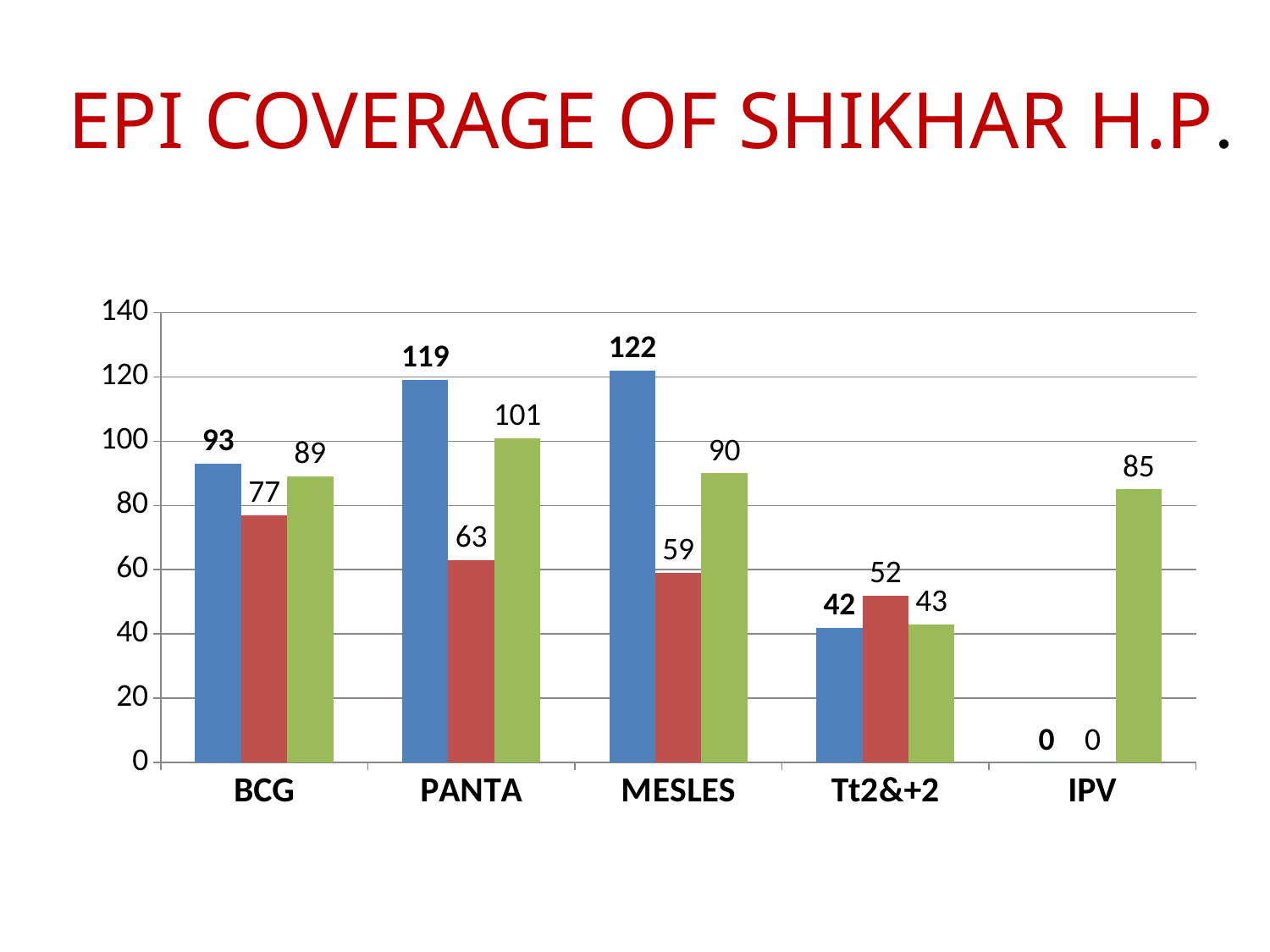
What is the value of the red bar for Tt2&+2? 52 Is the value of the blue bar for BCG greater or less than 100? less What is the difference between the blue bar and the red bar for PANTA? 56 What is the value of the blue bar for MESLES? 122 What is the value of the green bar for IPV? 85 Which is larger for BCG, the red bar or the green bar? the green bar Which category has the lowest green bar? Tt2&+2 Which category has the highest blue bar? MESLES How many categories are shown on the x axis? 5 What is the title of the slide? EPI COVERAGE OF SHIKHAR H.P. What is the value of the green bar for PANTA? 101 What kind of chart is shown on the slide? bar chart